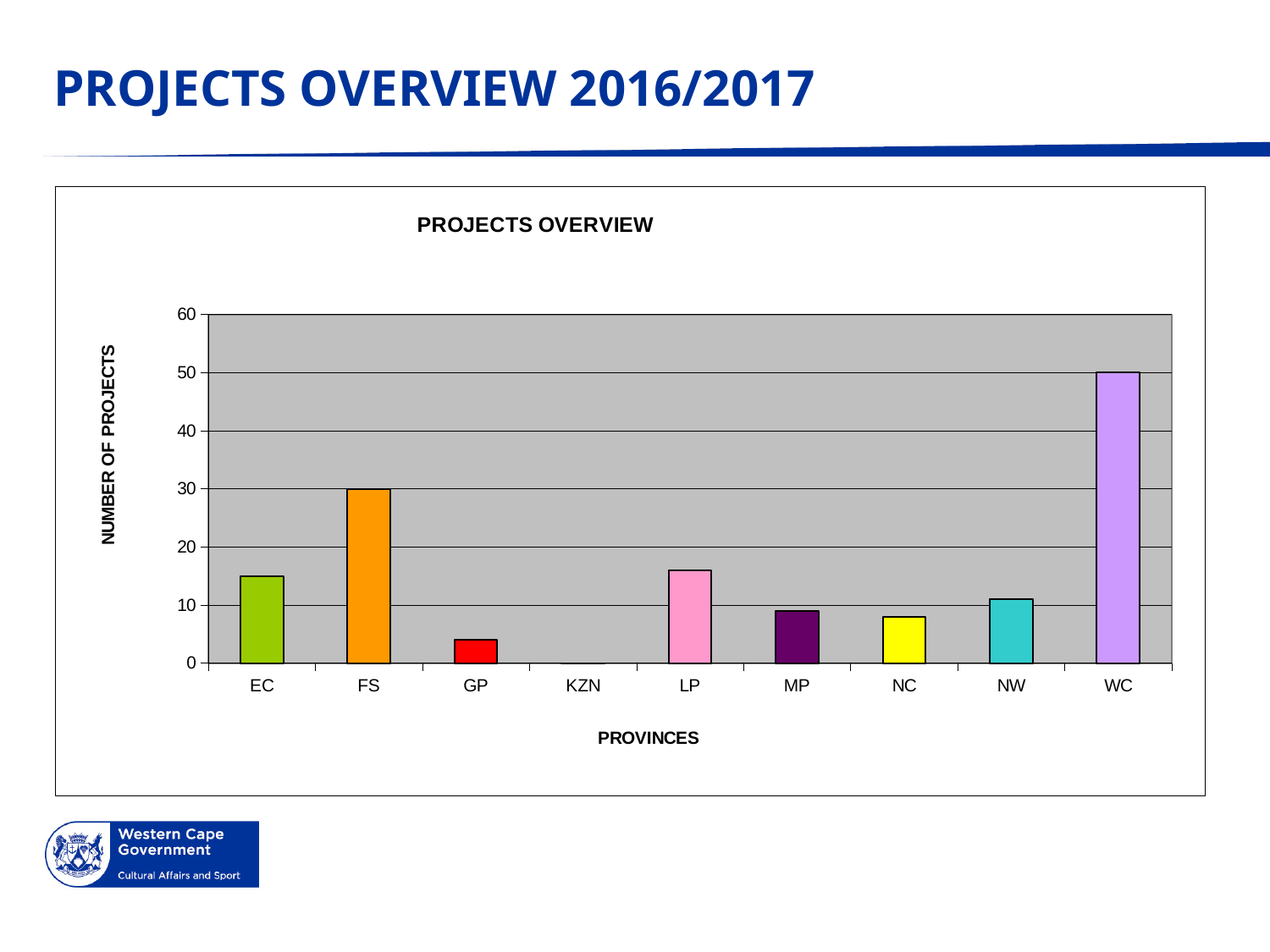
What is the number of projects for FS? 30 Is the number of projects for LP greater or less than 20? less Is the number of projects for GP greater or less than 10? less Is the number of projects for EC greater or less than 10? greater What is the number of projects for WC? 50 How many provinces are shown on the x axis of the chart? 9 Which has more projects, FS or LP? FS What is the label of the vertical axis of the chart? NUMBER OF PROJECTS Which province has the highest number of projects? WC Which province has the lowest number of projects? KZN What kind of chart is shown on the slide? bar chart What is the difference in the number of projects between WC and FS? 20